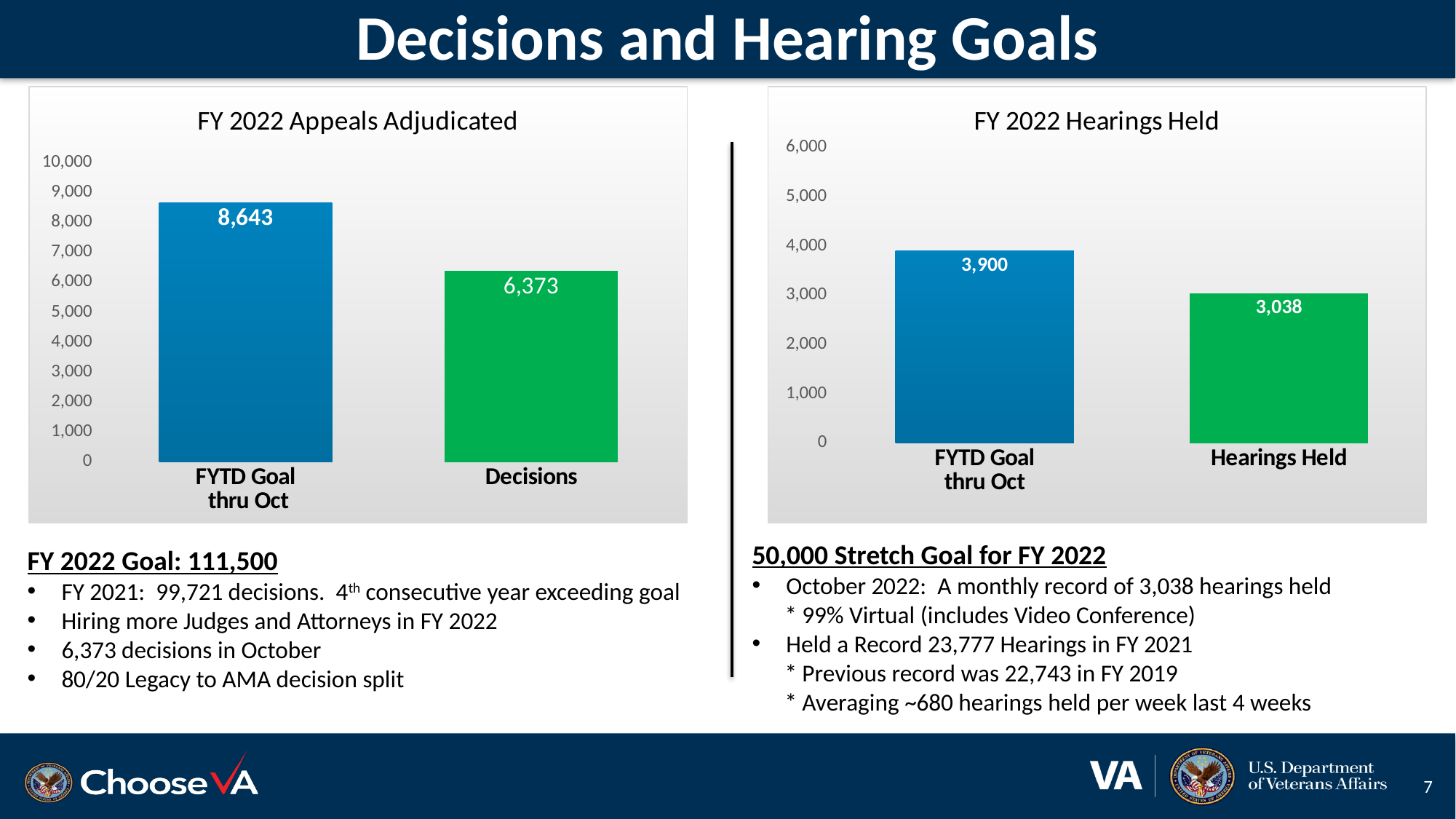
In the 'FY 2022 Hearings Held' chart, what is the value for FYTD Goal thru Oct? 3,900 What is the title of the chart on the left side of the slide? FY 2022 Appeals Adjudicated In the 'FY 2022 Appeals Adjudicated' chart, what is the value for FYTD Goal thru Oct? 8,643 In the 'FY 2022 Hearings Held' chart, what is the value for Hearings Held? 3,038 What type of chart is the 'FY 2022 Hearings Held' chart? bar chart In the 'FY 2022 Hearings Held' chart, which category has the lower value? Hearings Held In the 'FY 2022 Appeals Adjudicated' chart, which category has the higher value? FYTD Goal thru Oct In the 'FY 2022 Appeals Adjudicated' chart, what is the value for Decisions? 6,373 How many bars are shown in the 'FY 2022 Appeals Adjudicated' chart? 2 In the 'FY 2022 Hearings Held' chart, what is the difference between the FYTD Goal thru Oct and Hearings Held? 862 In the 'FY 2022 Appeals Adjudicated' chart, what is the difference between the FYTD Goal thru Oct and Decisions? 2,270 In the 'FY 2022 Hearings Held' chart, is the value for Hearings Held greater or less than 4,000? less